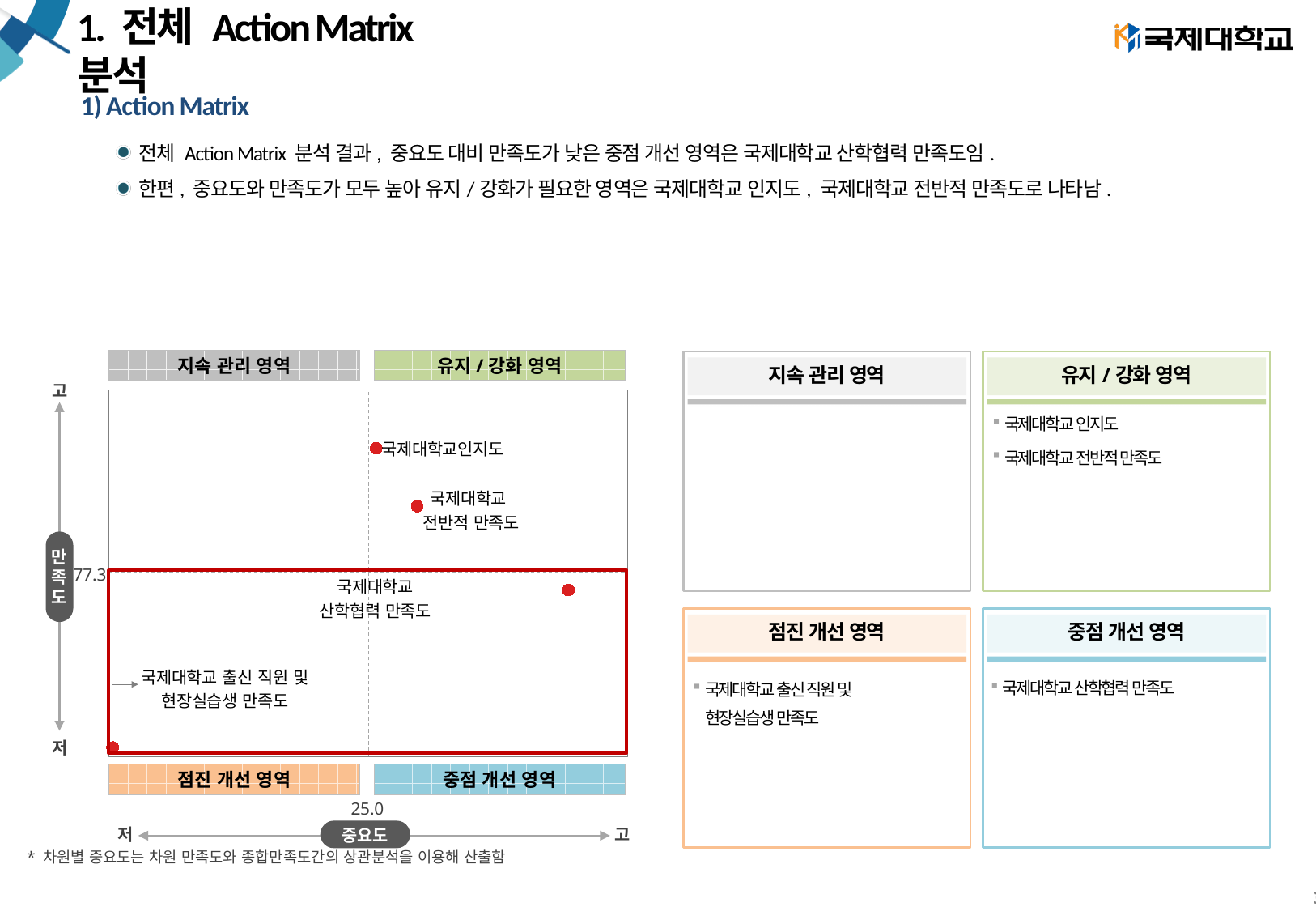
Which item has the lowest importance (중요도) in the Action Matrix? 국제대학교 출신 직원 및 현장실습생 만족도 Is the satisfaction value for 국제대학교인지도 greater or less than 77.3? greater Which item has the lowest satisfaction (만족도) in the Action Matrix? 국제대학교 출신 직원 및 현장실습생 만족도 Which item has the highest satisfaction (만족도) in the Action Matrix? 국제대학교인지도 What kind of chart is the Action Matrix on the slide? scatter chart Which has higher satisfaction, 국제대학교인지도 or 국제대학교 전반적 만족도? 국제대학교인지도 How many data points are plotted in the Action Matrix? 4 What is the satisfaction reference value marked on the vertical axis of the Action Matrix? 77.3 Is the importance value for 국제대학교 산학협력 만족도 greater or less than 25.0? greater Which item has the highest importance (중요도) in the Action Matrix? 국제대학교 산학협력 만족도 Which quadrant of the Action Matrix contains 국제대학교 산학협력 만족도? 중점 개선 영역 Is the satisfaction value for 국제대학교 산학협력 만족도 greater or less than 77.3? less